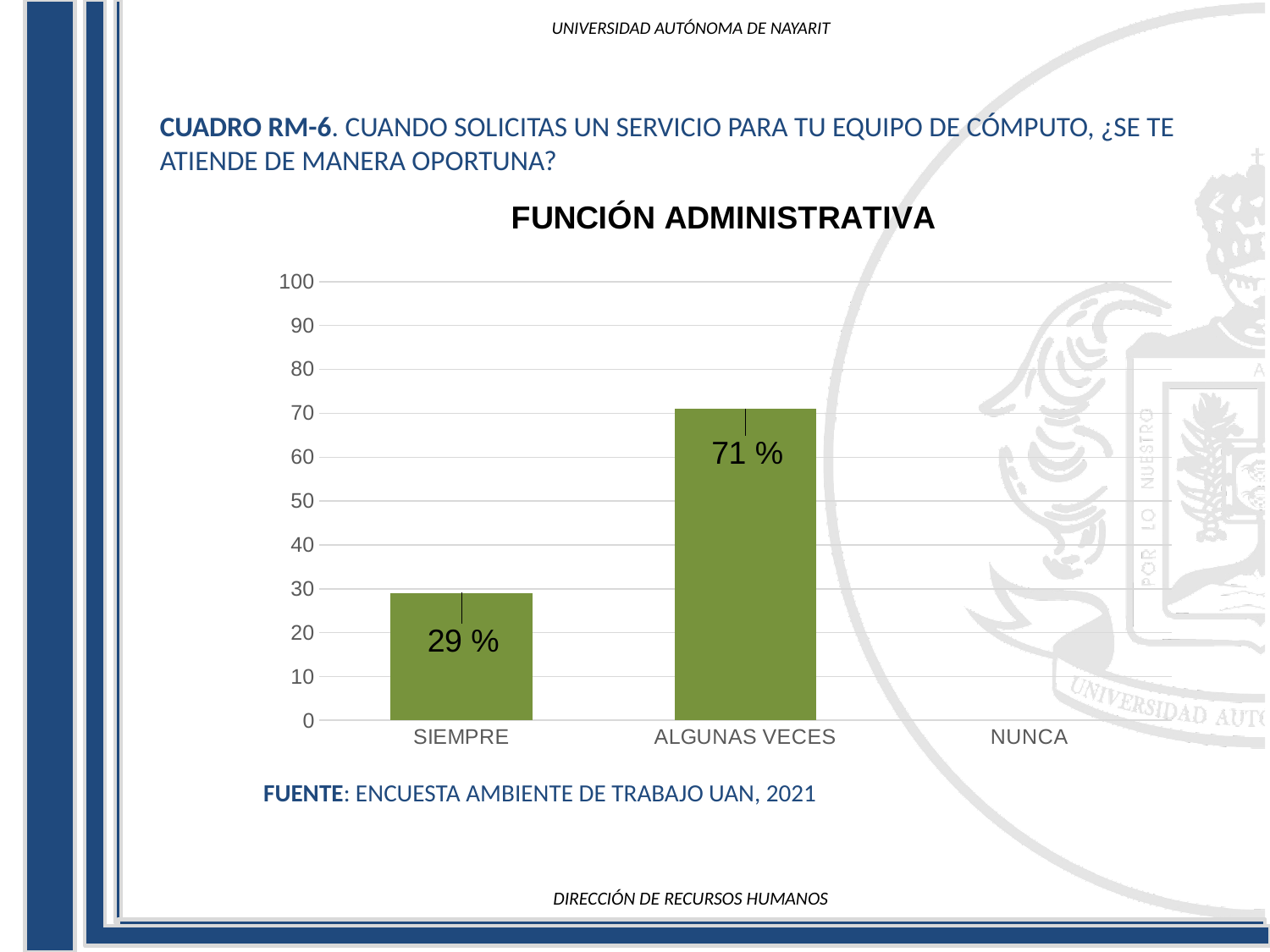
Is the value for SIEMPRE greater or less than 40? less What is the value for ALGUNAS VECES? 71 % What is the title of the chart? FUNCIÓN ADMINISTRATIVA What kind of chart is shown? bar chart What is the difference between the values for ALGUNAS VECES and SIEMPRE? 42 % What is the highest value shown on the y axis? 100 Which is larger, the value for SIEMPRE or the value for ALGUNAS VECES? ALGUNAS VECES Which category has the highest value? ALGUNAS VECES What is the value for SIEMPRE? 29 % Is the value for ALGUNAS VECES greater or less than 60? greater How many categories are shown on the x axis? 3